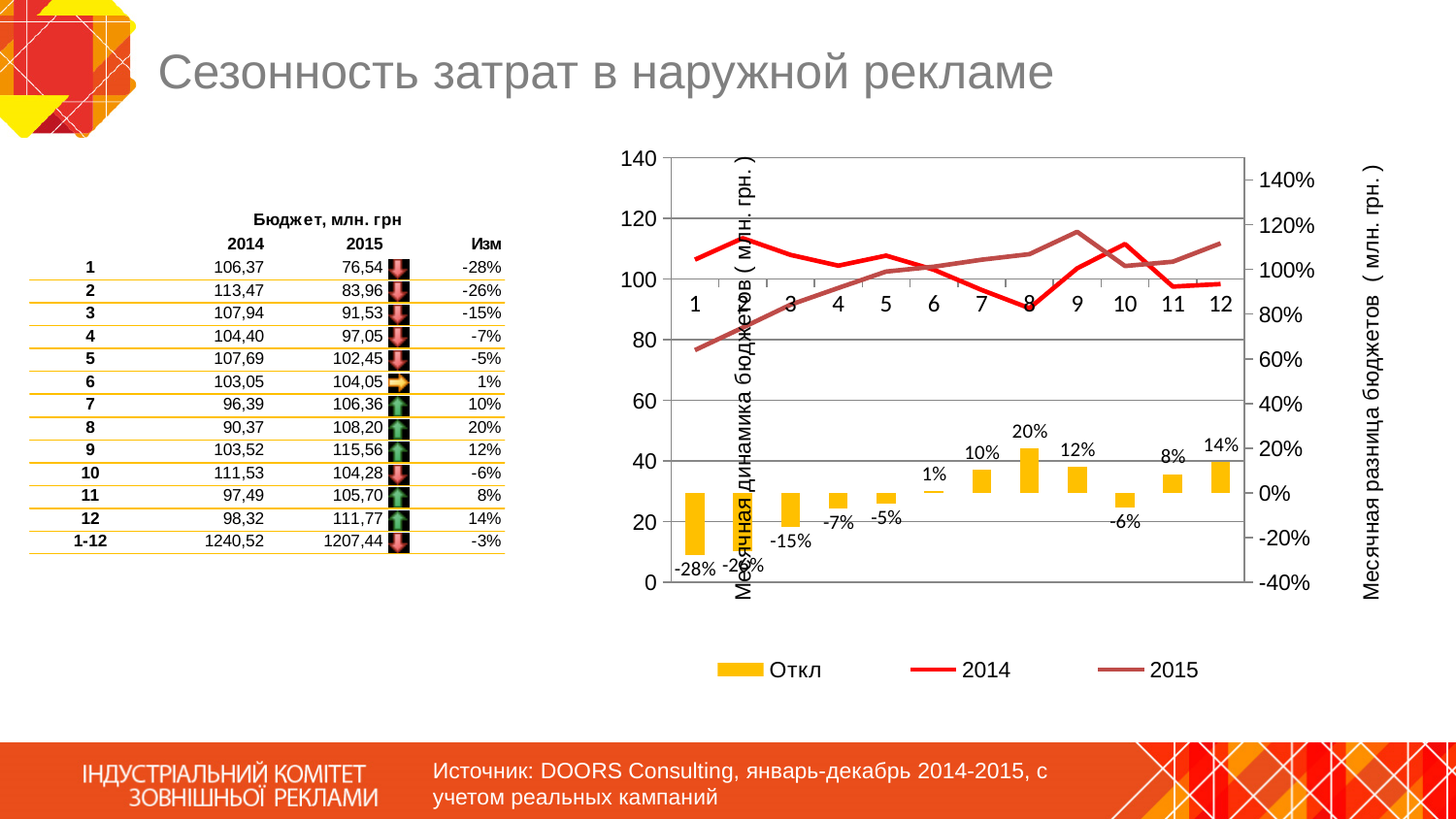
Which month has the lowest Откл bar in the chart? 1 Does the 2015 line rise or fall from month 1 to month 5? rise Which month has the highest Откл bar in the chart? 8 What is the Откл value for month 8 in the chart? 20% How many series does the chart legend list? 3 How many months (categories) are plotted along the x axis of the chart? 12 What are the three entries in the chart legend? Откл, 2014, 2015 Is the value of the 2014 line at month 8 greater or less than 100? less What is the difference between the Откл values for month 8 and month 9? 8 percentage points Which has the larger Откл value, month 7 or month 11? Month 7 What is the Откл value for month 12 in the chart? 14% What kind of chart is shown on the slide? A combined bar and line chart